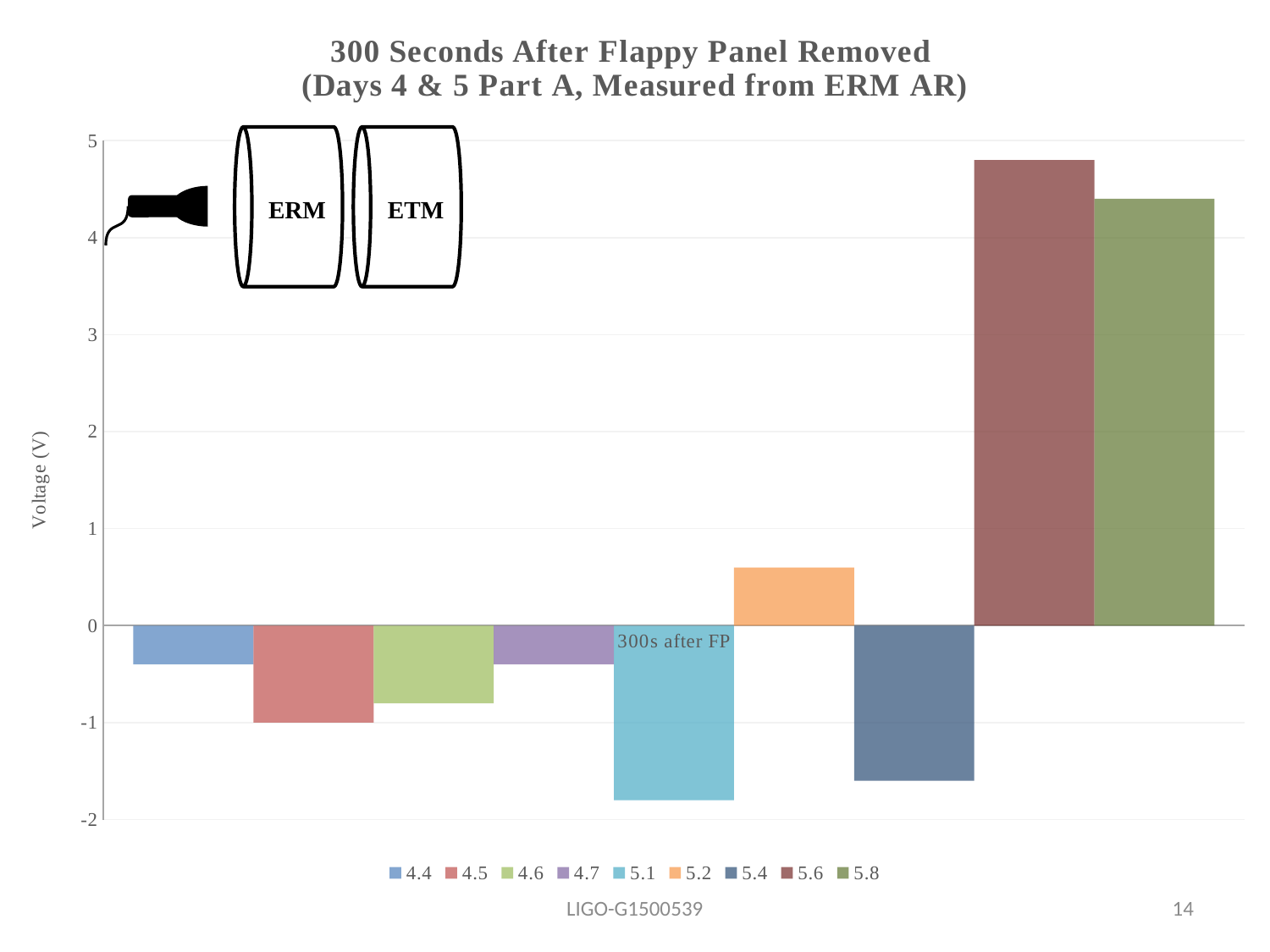
Is the value for series 5.2 greater or less than 1? less Which series has the larger value, 5.6 or 5.8? 5.6 What is the category label shown on the x axis? 300s after FP Which series has the larger value, 5.2 or 5.4? 5.2 What kind of chart is shown on the slide? bar chart Is the value for series 5.1 greater or less than -1? less Is the value for series 5.6 greater or less than 4? greater Which series has the highest value? 5.6 How many series does the legend list? 9 Which series has the lowest value? 5.1 What is the label on the vertical axis? Voltage (V)